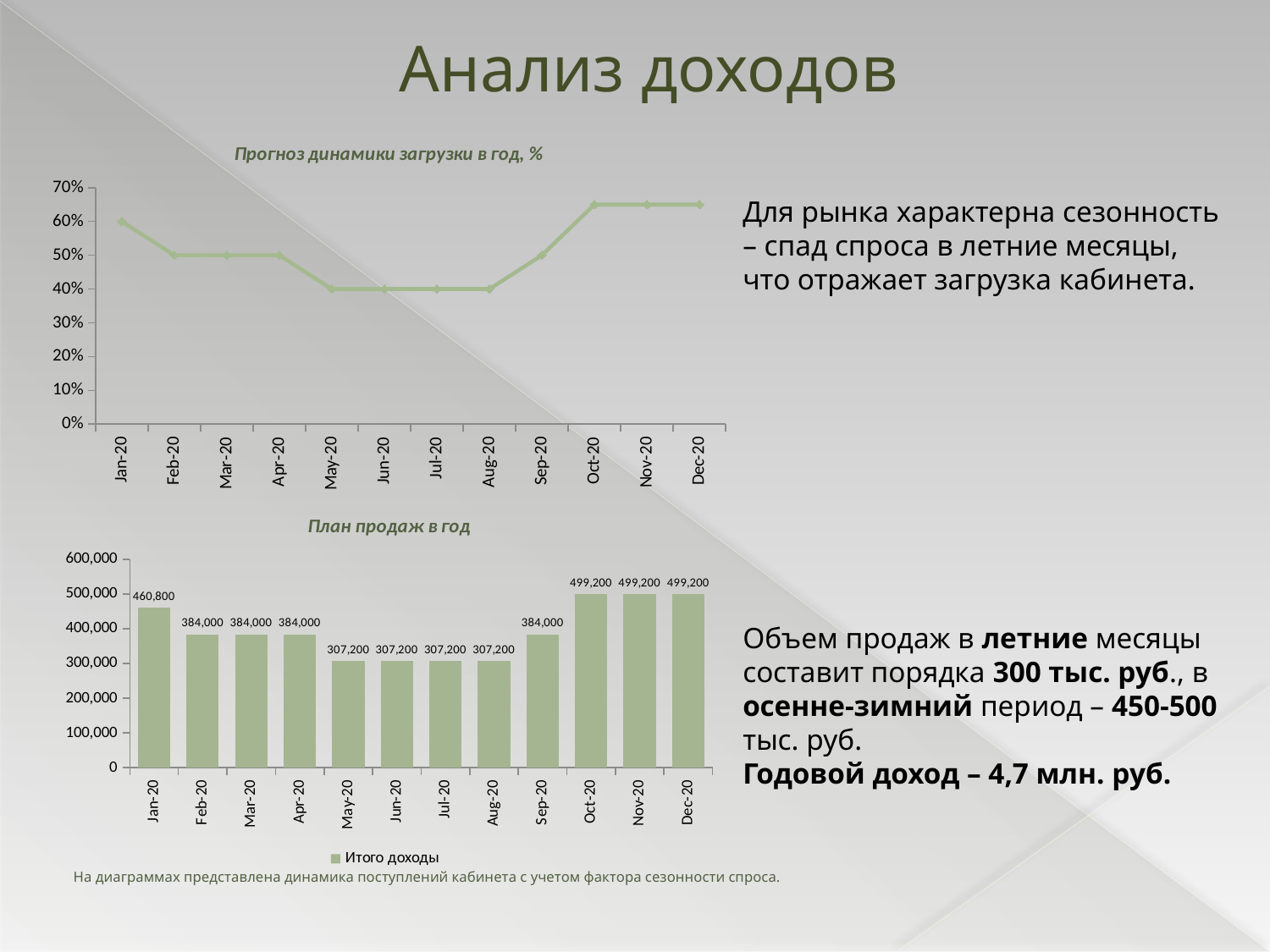
In the chart titled 'План продаж в год', what is the value for Jul-20? 307,200 What kind of chart is the chart titled 'Прогноз динамики загрузки в год, %'? line chart In the chart titled 'План продаж в год', what is the value for Jan-20? 460,800 In the chart titled 'План продаж в год', what is the value for Nov-20? 499,200 In the chart titled 'План продаж в год', how many bars are plotted? 12 In the chart titled 'Прогноз динамики загрузки в год, %', what is the value for Jan-20? 60% In the chart titled 'Прогноз динамики загрузки в год, %', what is the value for Jun-20? 40% In the chart titled 'План продаж в год', which is larger, the value for Sep-20 or the value for Aug-20? Sep-20 In the chart titled 'План продаж в год', what is the difference between the values for Jan-20 and Feb-20? 76,800 In the chart titled 'Прогноз динамики загрузки в год, %', is the value for Nov-20 greater or less than 60%? greater In the chart titled 'План продаж в год', what series name does the legend show? Итого доходы What kind of chart is the chart titled 'План продаж в год'? bar chart